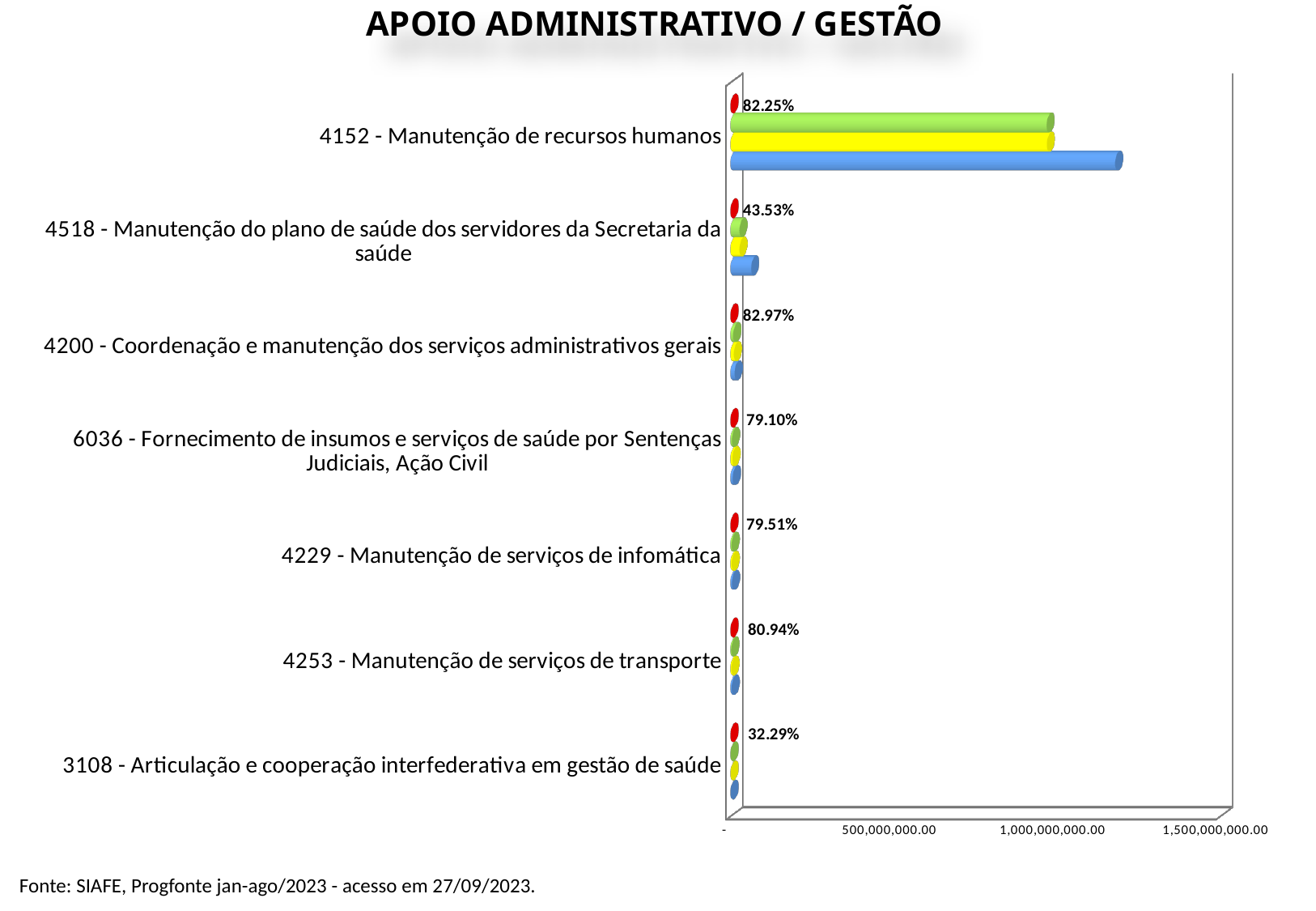
Is the value of the blue bar for 4152 - Manutenção de recursos humanos greater or less than 1,000,000,000.00? greater What is the title of the chart? APOIO ADMINISTRATIVO / GESTÃO What kind of chart is shown on the slide? Bar chart What percentage is shown for 3108 - Articulação e cooperação interfederativa em gestão de saúde? 32.29% Which has the larger percentage label: 4229 - Manutenção de serviços de infomática or 6036 - Fornecimento de insumos e serviços de saúde por Sentenças Judiciais, Ação Civil? 4229 - Manutenção de serviços de infomática How many categories are shown on the chart? 7 Which category has the lowest percentage label? 3108 - Articulação e cooperação interfederativa em gestão de saúde What is the difference between the percentage for 4200 - Coordenação e manutenção dos serviços administrativos gerais and the percentage for 3108 - Articulação e cooperação interfederativa em gestão de saúde? 50.68 percentage points Which category has the highest percentage label? 4200 - Coordenação e manutenção dos serviços administrativos gerais What percentage is shown for 4518 - Manutenção do plano de saúde dos servidores da Secretaria da saúde? 43.53% What percentage is shown for 4152 - Manutenção de recursos humanos? 82.25% Is the value of the blue bar for 4518 - Manutenção do plano de saúde dos servidores da Secretaria da saúde greater or less than 500,000,000.00? less